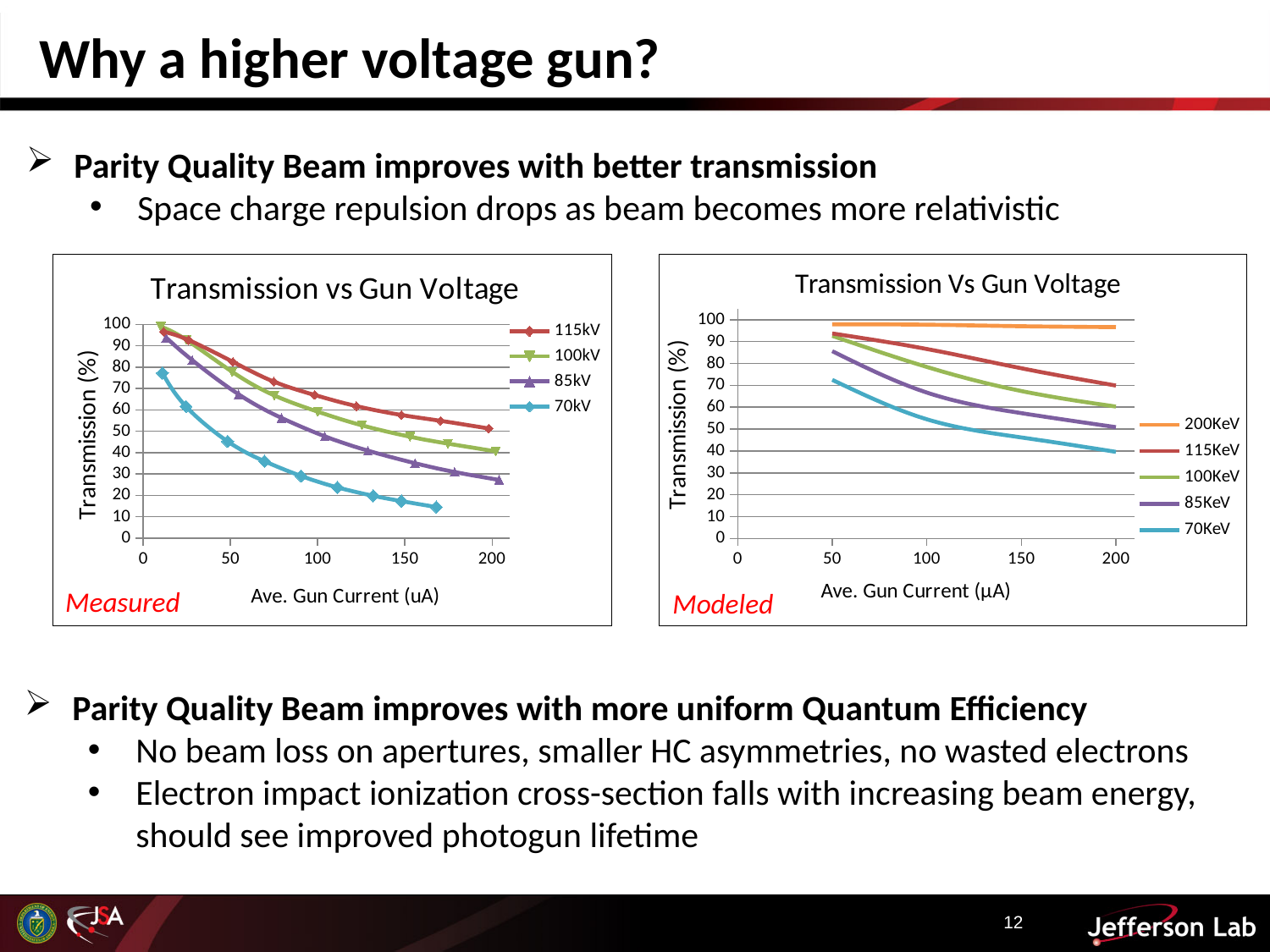
How many series does the legend of the right chart (Modeled) list? 5 In the right chart (Modeled), which series has the higher transmission at 200 µA, 200KeV or 70KeV? 200KeV What type of chart is the left chart titled 'Transmission vs Gun Voltage' (Measured)? line chart In the left chart (Measured), does transmission rise or fall as average gun current increases? fall In the right chart (Modeled), is the transmission for the 70KeV series at 200 µA greater or less than 50? less In the left chart (Measured), is the transmission for the 70kV series at 50 uA greater or less than 50? less In the left chart (Measured), is the transmission for the 115kV series at 100 uA greater or less than 60? greater What is the x-axis label of the right chart (Modeled)? Ave. Gun Current (µA) In the left chart (Measured), which series has the higher transmission at 100 uA, 115kV or 70kV? 115kV How many series does the legend of the left chart (Measured) list? 4